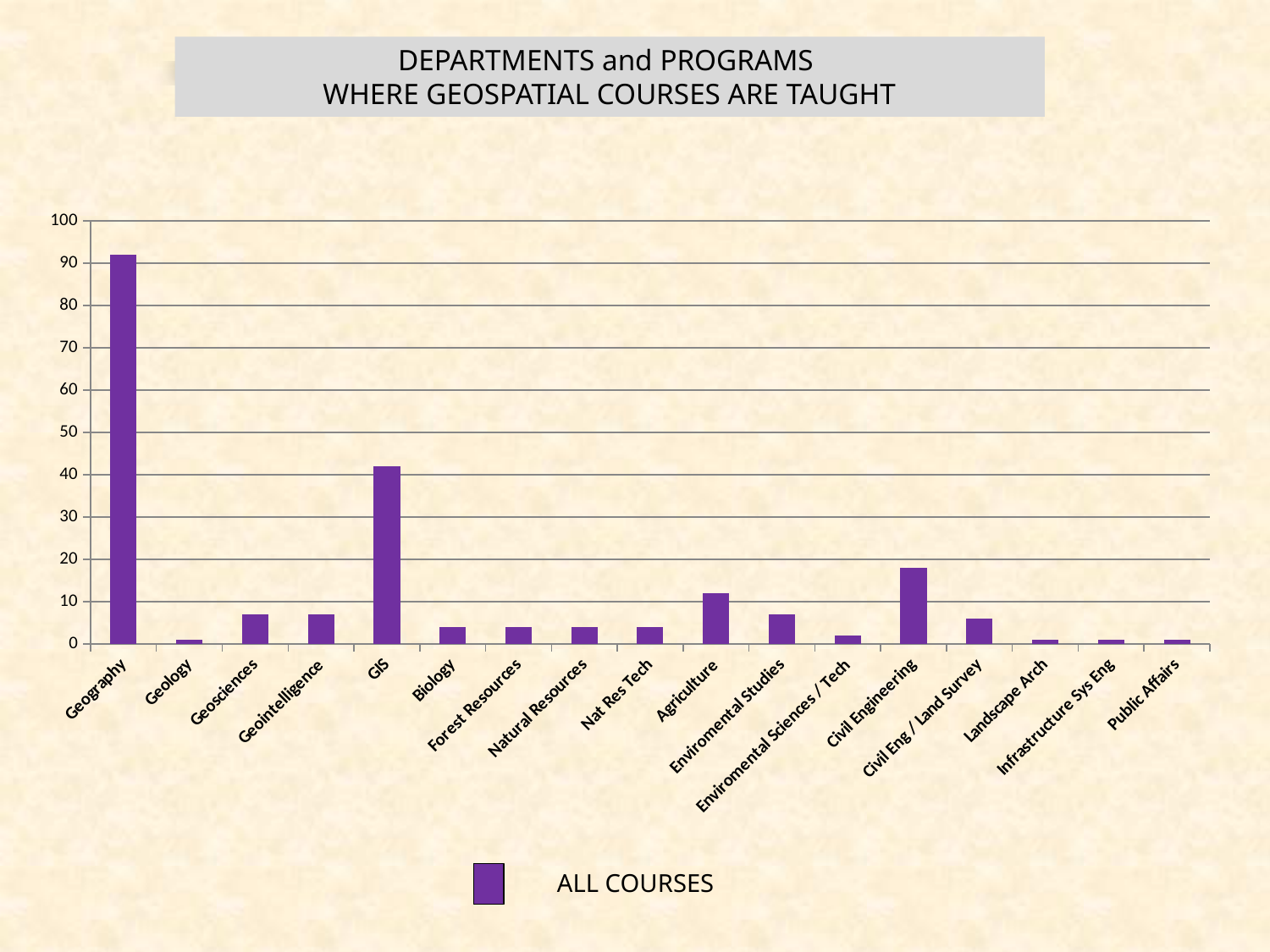
Is the value for Civil Engineering greater or less than 20? less Which has more courses, GIS or Civil Engineering? GIS What is the legend entry for the series? ALL COURSES Is the value for Agriculture greater or less than 10? greater Is the value for GIS greater or less than 40? greater How many series does the legend list? 1 How many departments or programs are shown on the x axis? 17 What kind of chart is shown on the slide? bar chart Which department or program has the highest number of courses? Geography What is the title of the chart? DEPARTMENTS and PROGRAMS WHERE GEOSPATIAL COURSES ARE TAUGHT Which has more courses, Agriculture or Biology? Agriculture